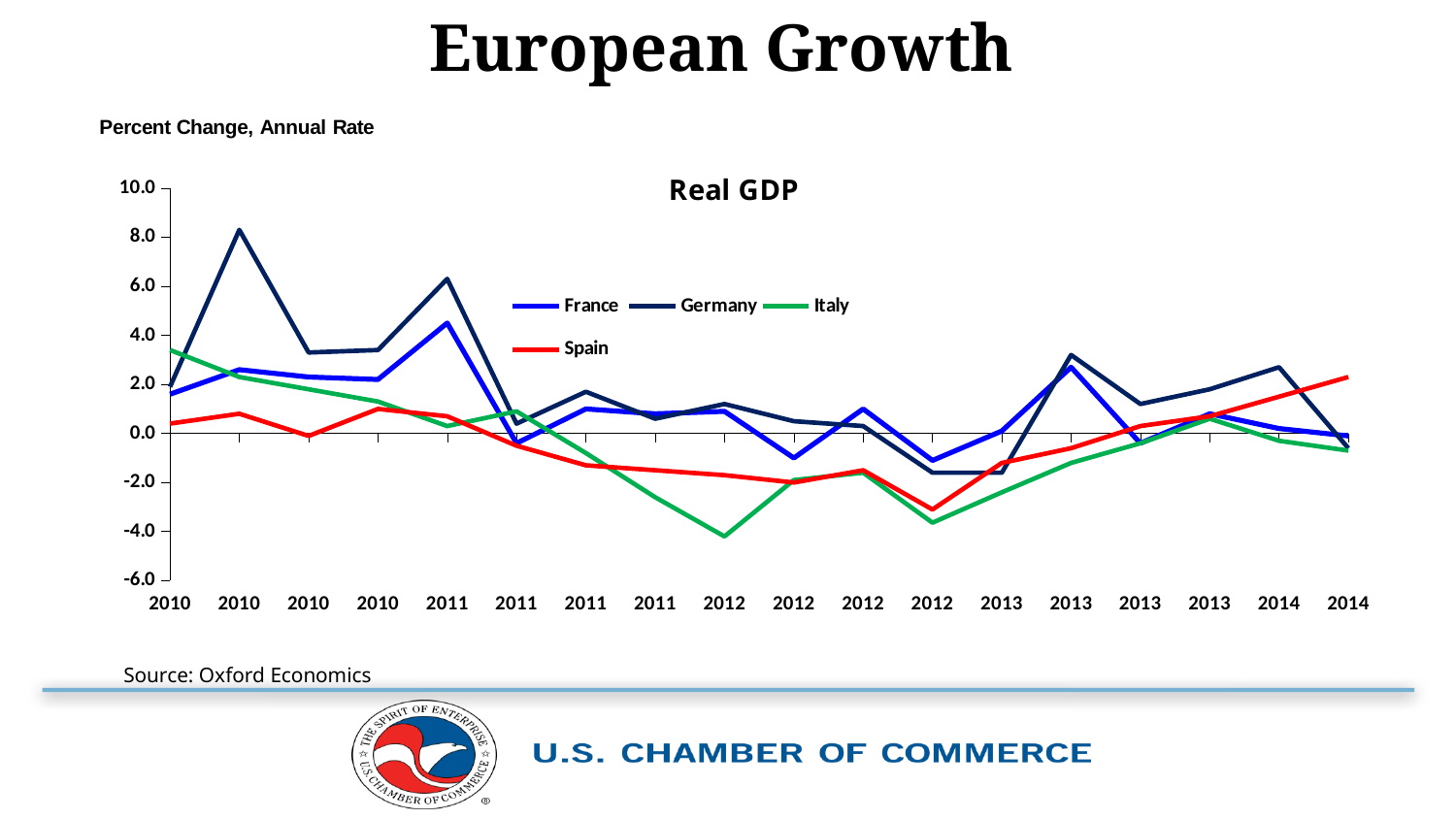
What kind of chart is shown on the slide? line chart Is Spain's value at the last 2014 point greater or less than 0.0? greater Is Italy's value at the first 2012 point greater or less than -2.0? less Which series reaches the highest value anywhere on the Real GDP chart? Germany What is the title of the chart on the slide? Real GDP Which countries are listed in the legend of the Real GDP chart? France, Germany, Italy, Spain Does Spain's line rise or fall from the last 2012 point to the last 2014 point? rise At the first 2010 point, which is larger: the value for Italy or the value for France? Italy How many points are plotted along the x axis of the Real GDP chart? 18 Which series reaches the lowest value anywhere on the Real GDP chart? Italy Is Germany's value at the second 2010 point greater or less than 6.0? greater How many series does the legend of the Real GDP chart list? 4